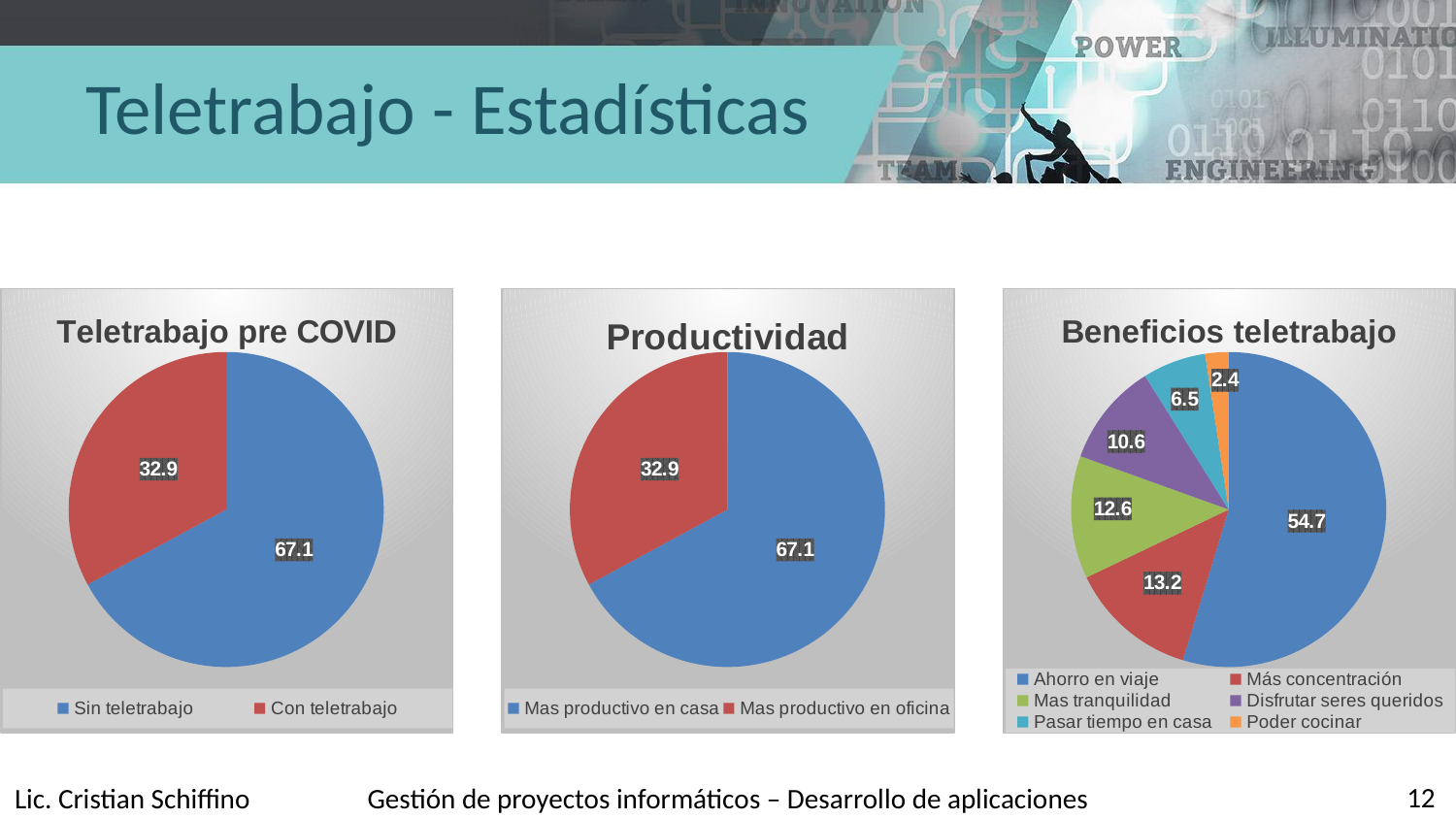
In the 'Beneficios teletrabajo' chart, which category has the highest value? Ahorro en viaje In the 'Beneficios teletrabajo' chart, what is the difference between 'Más concentración' and 'Disfrutar seres queridos'? 2.6 In the 'Beneficios teletrabajo' chart, what is the value for 'Mas tranquilidad'? 12.6 What type of chart is the 'Productividad' chart? Pie chart In the 'Teletrabajo pre COVID' chart, what is the value for 'Con teletrabajo'? 32.9 In the 'Beneficios teletrabajo' chart, which category has the lowest value? Poder cocinar In the 'Beneficios teletrabajo' chart, what colour is the 'Pasar tiempo en casa' slice? Teal (light blue) In the 'Teletrabajo pre COVID' chart, what is the value for 'Sin teletrabajo'? 67.1 How many categories does the 'Beneficios teletrabajo' chart show? 6 In the 'Productividad' chart, what is the value for 'Mas productivo en oficina'? 32.9 In the 'Teletrabajo pre COVID' chart, what is the difference between 'Sin teletrabajo' and 'Con teletrabajo'? 34.2 In the 'Productividad' chart, which category is larger, 'Mas productivo en casa' or 'Mas productivo en oficina'? Mas productivo en casa